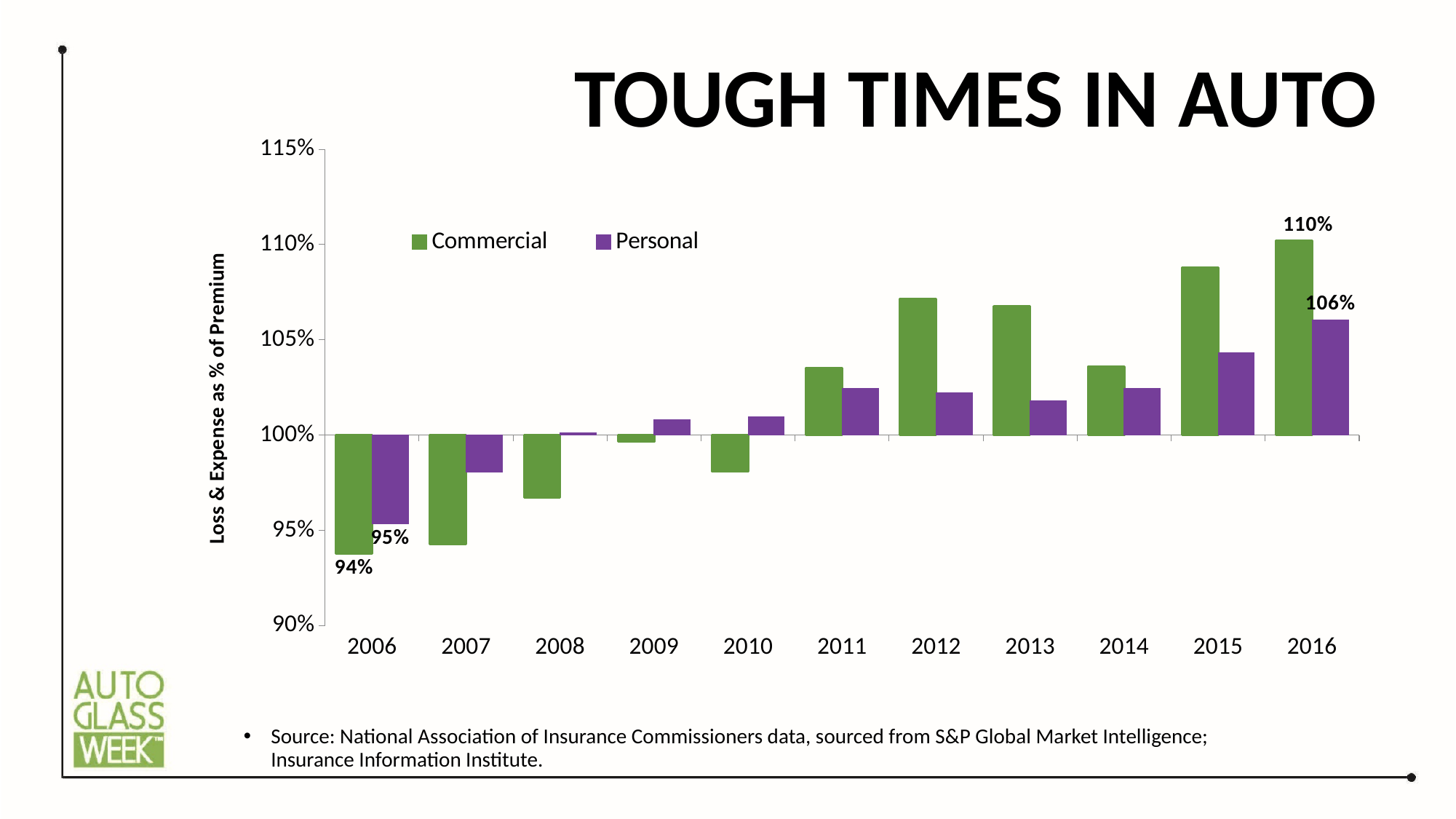
How many years are shown on the x axis? 11 What kind of chart is shown on the slide? Bar chart What is the difference between the Commercial and Personal values in 2016? 4 percentage points Is the Commercial value for 2012 greater or less than 105%? greater What is the Personal value for 2016? 106% What is the Commercial value for 2006? 94% Which is larger, the Commercial value for 2015 or the Commercial value for 2014? 2015 In which year is the Commercial series highest? 2016 In which year is the Personal series lowest? 2006 How many series does the legend list? 2 Is the Personal value for 2010 greater or less than 105%? less What is the Commercial value for 2016? 110%